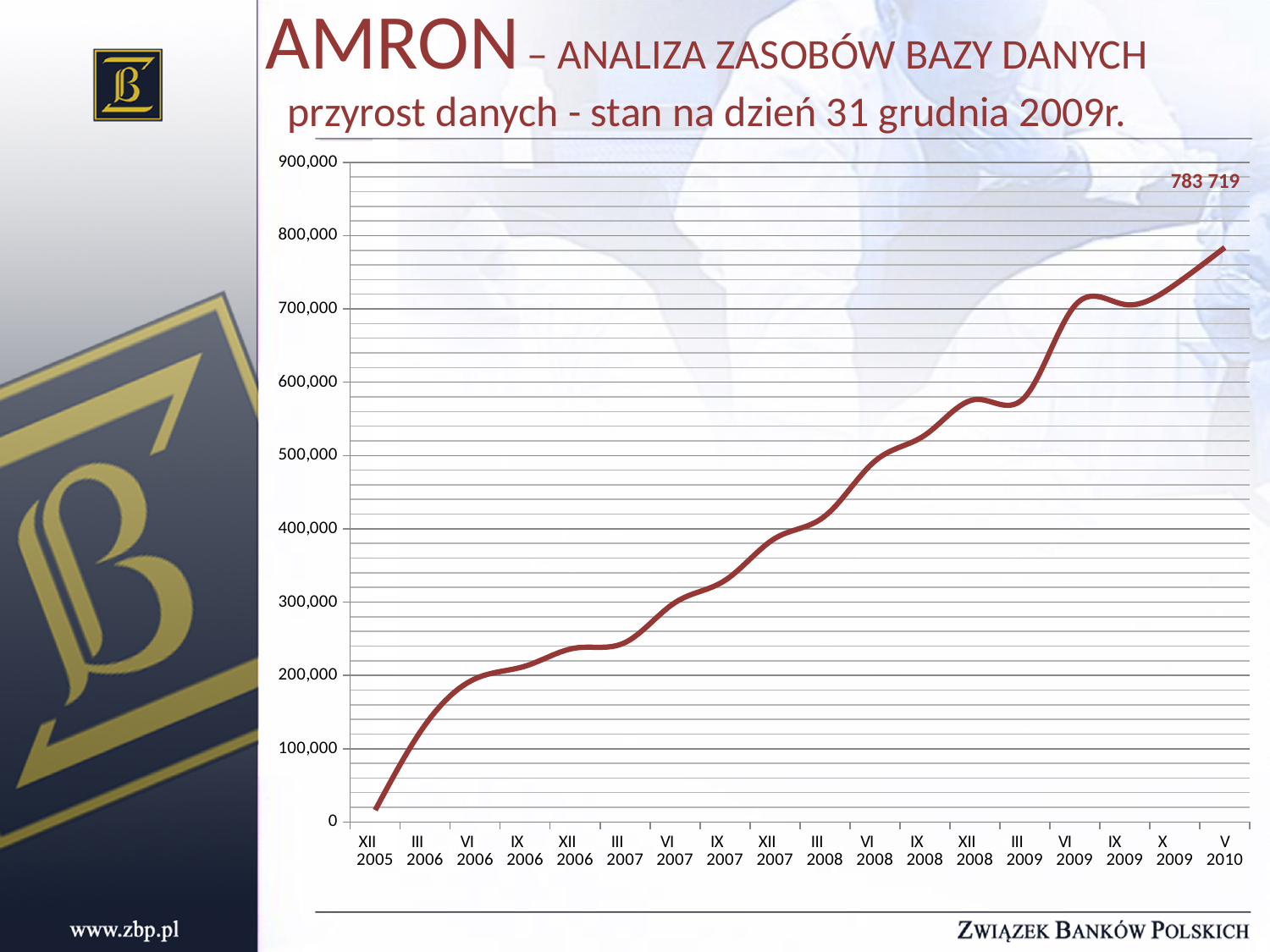
Which period has the highest value on the chart? V 2010 Is the value for XII 2006 greater or less than 200,000? greater Is the value for XII 2005 greater or less than 100,000? less What value is printed as the data label at the end of the line? 783 719 Do the values generally rise or fall from XII 2005 to V 2010? rise Which period has the lowest value on the chart? XII 2005 How many periods are labelled on the x axis? 18 What is the highest value shown on the y axis? 900,000 Which is larger, the value for XII 2008 or the value for XII 2006? XII 2008 Is the value for XII 2008 greater or less than 500,000? greater What kind of chart is shown on the slide? line chart